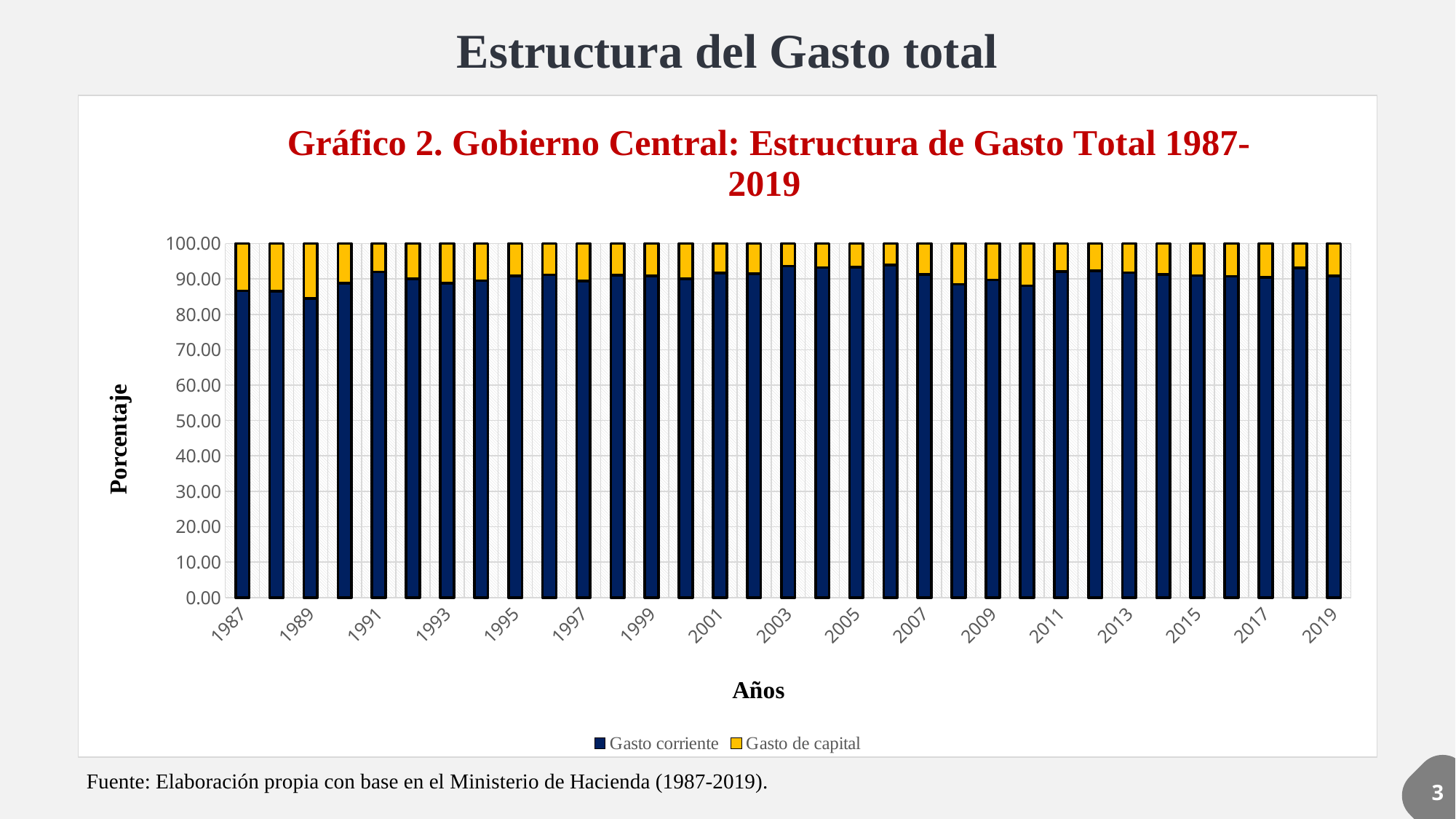
What kind of chart is shown on the slide? Stacked bar chart How many series does the legend list? 2 Is the value of Gasto corriente for 2003 greater or less than 90? greater Which year has a larger Gasto corriente share, 1989 or 2003? 2003 Which year has a larger Gasto corriente share, 2006 or 2010? 2006 What is the total of the stacked bar for 1995? 100.00 What are the two series named in the legend? Gasto corriente and Gasto de capital What is the label of the vertical axis? Porcentaje Is the value of Gasto corriente for 1989 greater or less than 90? less How many years (bars) are plotted on the chart? 33 Is the value of Gasto corriente for 2010 greater or less than 90? less